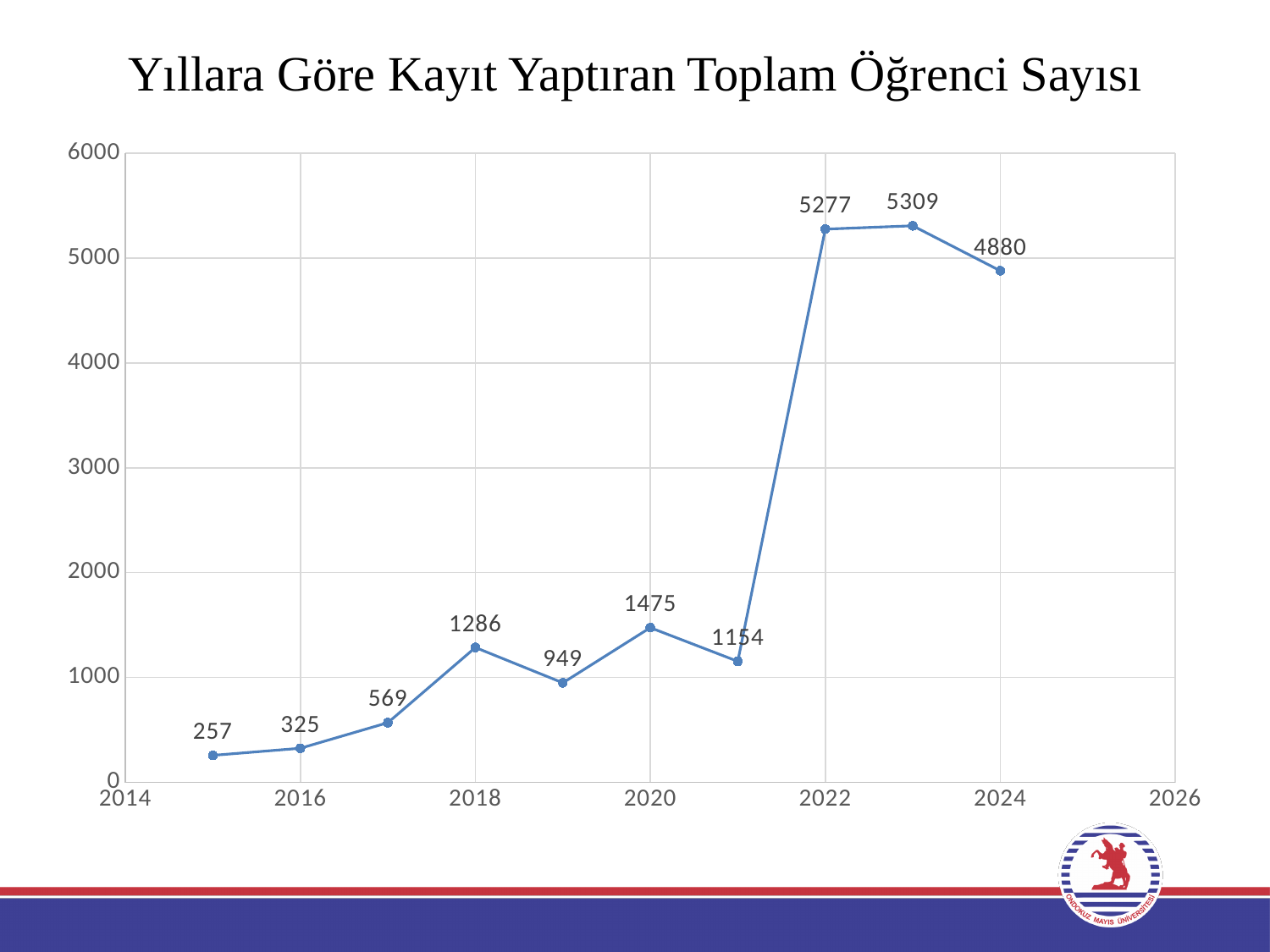
How many data points are plotted on the chart? 10 What is the lowest value plotted on the chart? 257 What is the value for 2016? 325 What is the highest value plotted on the chart? 5309 What is the title of the chart? Yıllara Göre Kayıt Yaptıran Toplam Öğrenci Sayısı What kind of chart is shown on the slide? line chart What is the value for 2018? 1286 What is the value for 2020? 1475 Which is larger, the value for 2018 or the value for 2020? 2020 What is the value for 2022? 5277 What is the value for 2024? 4880 What is the difference between the values for 2022 and 2020? 3802